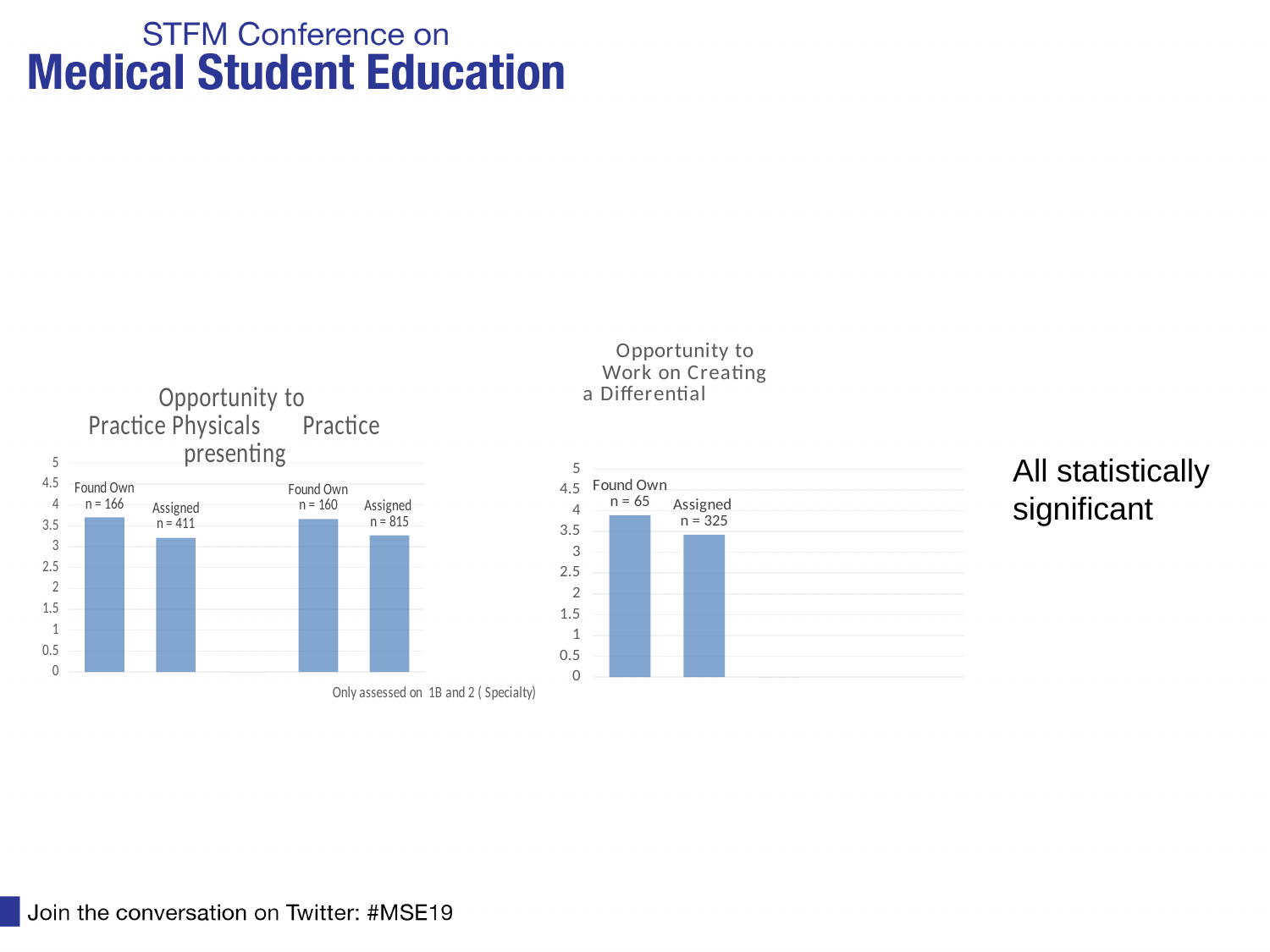
In the left chart, is the value for Assigned (n = 411) greater or less than 3.5? less In the left chart, is the value for Assigned (n = 815) greater or less than 3.5? less In the left chart (Opportunity to Practice Physicals / Practice presenting), how many bars are plotted? 4 In the left chart, under Opportunity to Practice Physicals, which bar is taller, Found Own (n = 166) or Assigned (n = 411)? Found Own (n = 166) In the 'Opportunity to Work on Creating a Differential' chart, what is the n for the Assigned group? n = 325 In the 'Opportunity to Work on Creating a Differential' chart, is the value for Assigned (n = 325) greater or less than 4? less In the 'Opportunity to Work on Creating a Differential' chart, how many bars are plotted? 2 In the 'Opportunity to Work on Creating a Differential' chart, which bar is taller, Found Own or Assigned? Found Own What kind of chart is the 'Opportunity to Work on Creating a Differential' chart? bar chart In the left chart, under Practice presenting, which bar is taller, Found Own (n = 160) or Assigned (n = 815)? Found Own (n = 160)